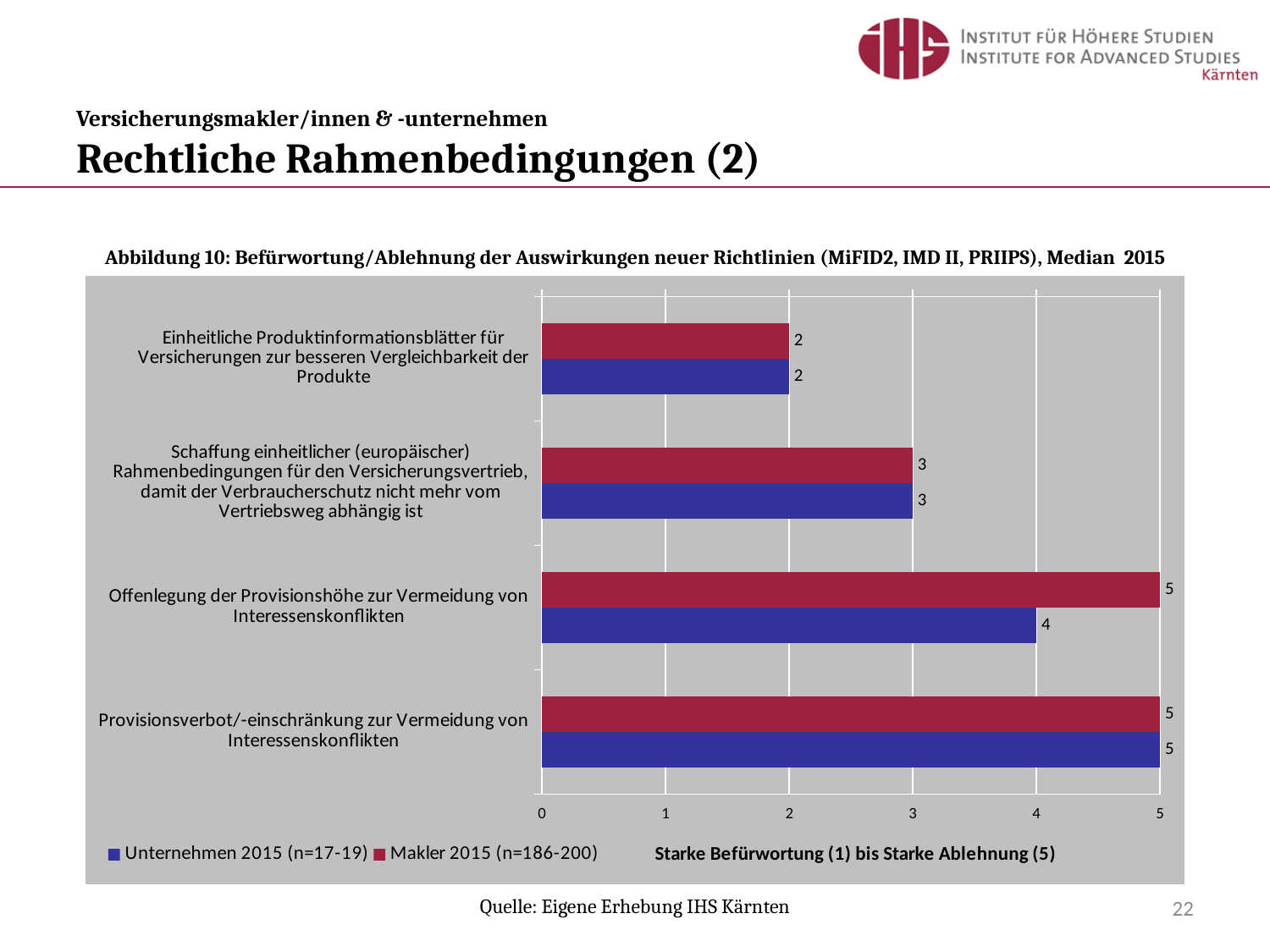
Which category has the lowest value for Makler 2015? Einheitliche Produktinformationsblätter für Versicherungen zur besseren Vergleichbarkeit der Produkte What is the value for Makler 2015 for "Offenlegung der Provisionshöhe zur Vermeidung von Interessenskonflikten"? 5 What is the value for Unternehmen 2015 for "Offenlegung der Provisionshöhe zur Vermeidung von Interessenskonflikten"? 4 What kind of chart is shown on the slide? Bar chart What is the value for Unternehmen 2015 for "Einheitliche Produktinformationsblätter für Versicherungen zur besseren Vergleichbarkeit der Produkte"? 2 What is the value for Makler 2015 for "Schaffung einheitlicher (europäischer) Rahmenbedingungen für den Versicherungsvertrieb, damit der Verbraucherschutz nicht mehr vom Vertriebsweg abhängig ist"? 3 What colour represents the Makler 2015 (n=186-200) series in the chart? Red Is the Unternehmen 2015 value for "Provisionsverbot/-einschränkung zur Vermeidung von Interessenskonflikten" greater or less than 3? greater For "Offenlegung der Provisionshöhe zur Vermeidung von Interessenskonflikten", which series has the larger value, Makler 2015 or Unternehmen 2015? Makler 2015 How many series does the legend list? 2 How many categories are shown on the chart? 4 What is the difference between the Makler 2015 and Unternehmen 2015 values for "Offenlegung der Provisionshöhe zur Vermeidung von Interessenskonflikten"? 1